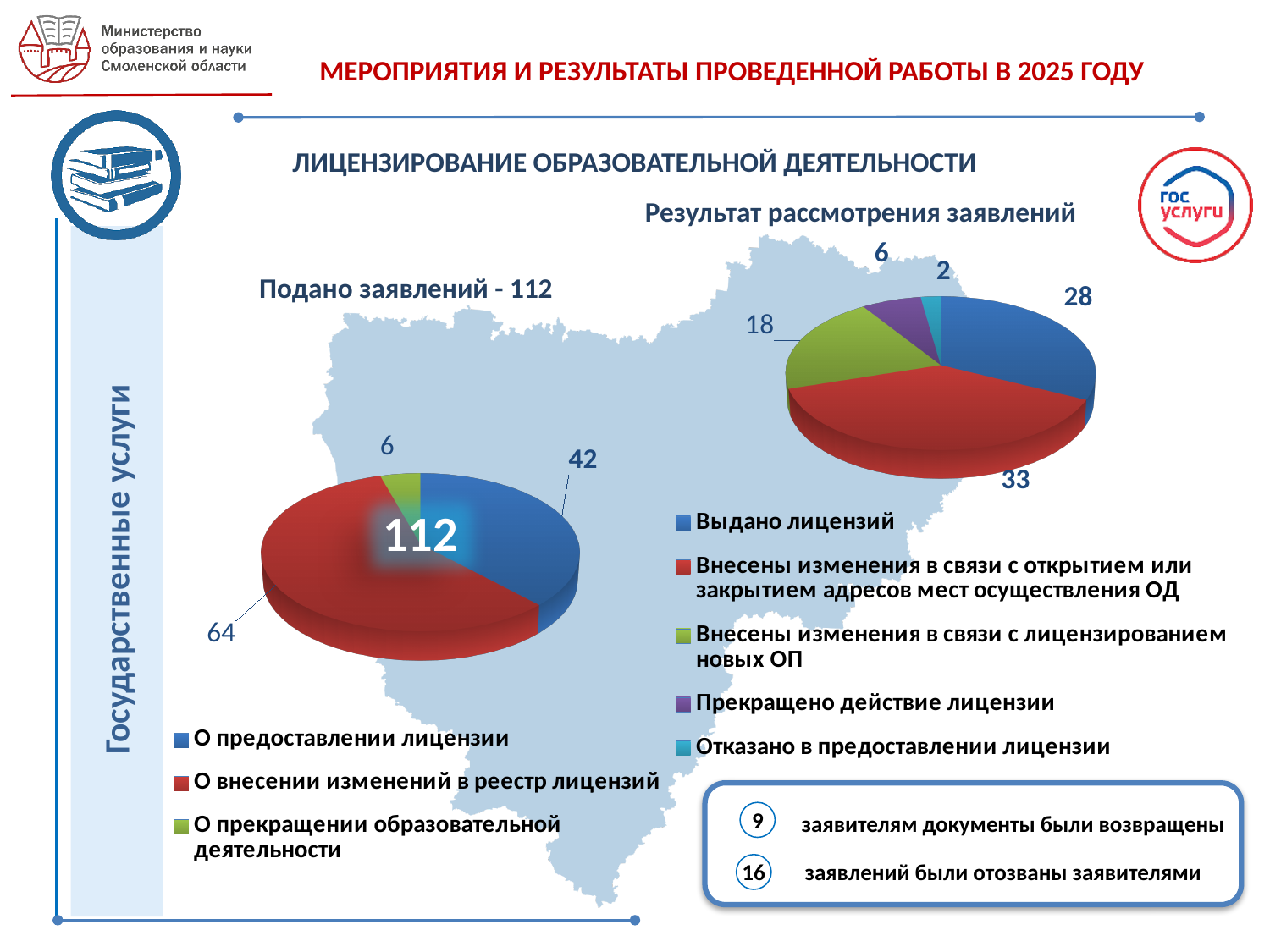
On the right pie chart 'Результат рассмотрения заявлений', which is larger: 'Выдано лицензий' or 'Внесены изменения в связи с лицензированием новых ОП'? Выдано лицензий On the left pie chart 'Подано заявлений - 112', what is the value for 'О внесении изменений в реестр лицензий'? 64 On the right pie chart 'Результат рассмотрения заявлений', how many categories does the legend list? 5 On the right pie chart 'Результат рассмотрения заявлений', which category has the largest value? Внесены изменения в связи с открытием или закрытием адресов мест осуществления ОД What type of chart is used for 'Результат рассмотрения заявлений'? Pie chart On the right pie chart 'Результат рассмотрения заявлений', what is the value for 'Отказано в предоставлении лицензии'? 2 On the left pie chart 'Подано заявлений - 112', what is the value for 'О предоставлении лицензии'? 42 On the left pie chart 'Подано заявлений - 112', which category has the smallest value? О прекращении образовательной деятельности On the right pie chart 'Результат рассмотрения заявлений', what is the difference between 'Прекращено действие лицензии' and 'Отказано в предоставлении лицензии'? 4 On the right pie chart 'Результат рассмотрения заявлений', what is the value for 'Выдано лицензий'? 28 On the left pie chart 'Подано заявлений - 112', how many categories does the legend list? 3 On the left pie chart 'Подано заявлений - 112', what is the difference between 'О внесении изменений в реестр лицензий' and 'О предоставлении лицензии'? 22